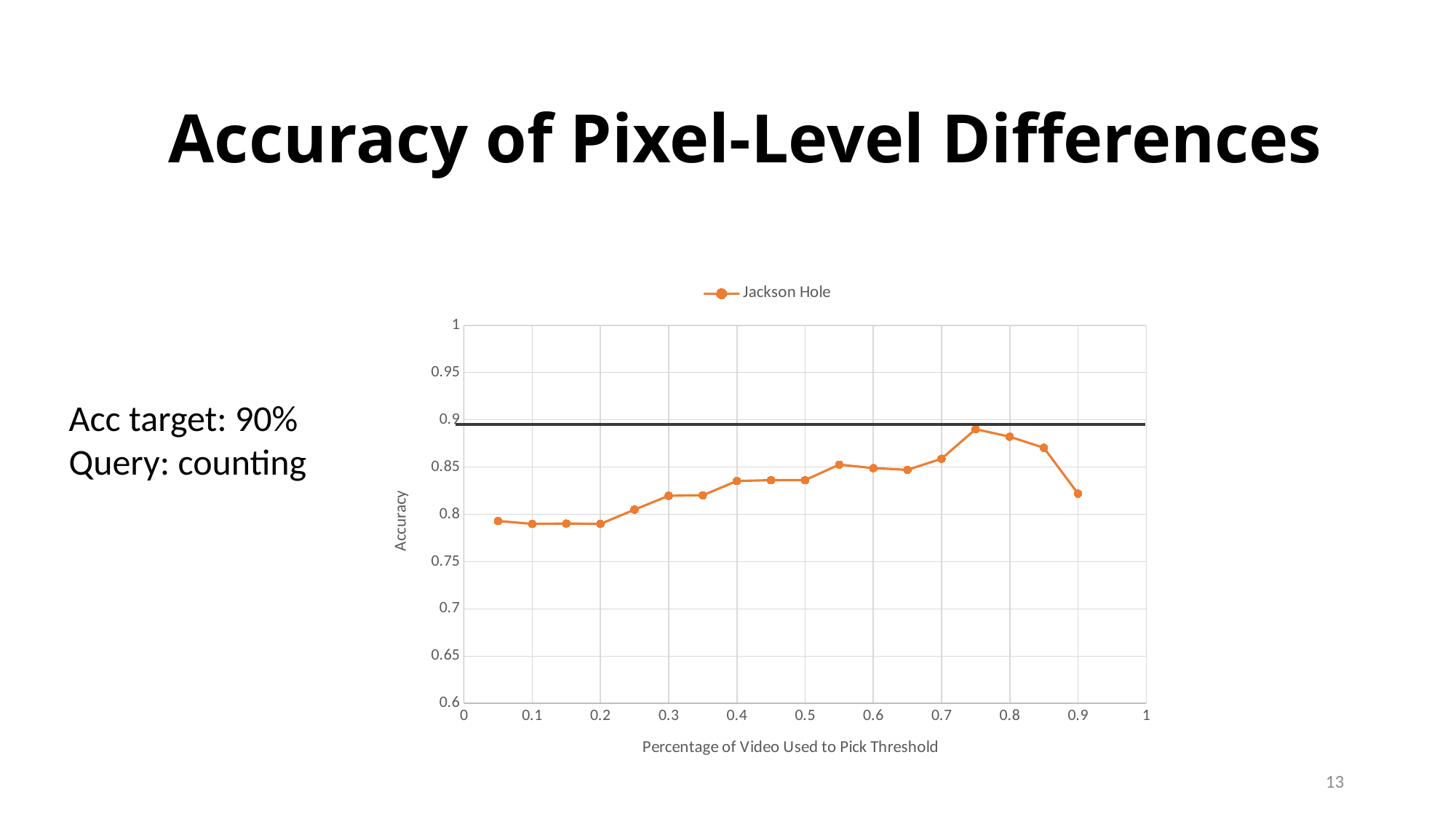
What is the title of the x axis? Percentage of Video Used to Pick Threshold How many data points are plotted on the Jackson Hole line? 18 Does the accuracy generally rise or fall between x = 0.2 and x = 0.75? Rise At which x value does the Jackson Hole line reach its highest accuracy? 0.75 What is the name of the series shown in the legend? Jackson Hole How many series does the legend list? 1 Is the accuracy at x = 0.5 greater or less than 0.85? less Is the accuracy at x = 0.75 greater or less than 0.85? greater Is the accuracy at x = 0.9 greater or less than 0.8? greater Which has the higher accuracy: x = 0.3 or x = 0.05? 0.3 Which has the higher accuracy: x = 0.75 or x = 0.9? 0.75 What kind of chart is shown on the slide? Line chart